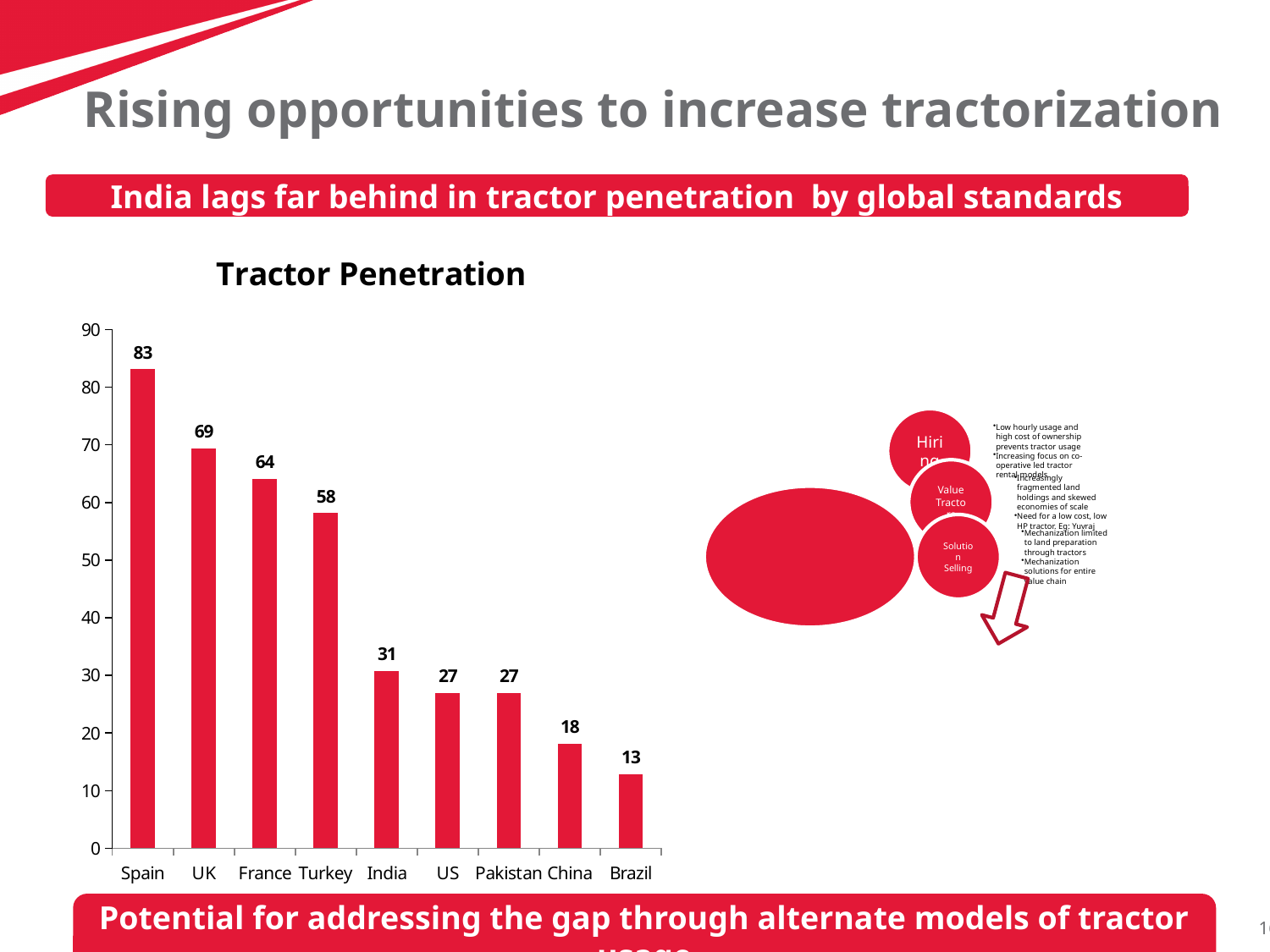
Which country has the highest tractor penetration in the chart? Spain What is the difference in tractor penetration between Spain and India? 52 Which country has the lowest tractor penetration in the chart? Brazil What is the difference in tractor penetration between UK and France? 5 What type of chart is used to show Tractor Penetration? Bar chart What is the tractor penetration value for Spain? 83 What is the tractor penetration value for India? 31 Do the tractor penetration values rise or fall from Spain to Brazil along the x axis? Fall Which has a higher tractor penetration, Turkey or China? Turkey Is the tractor penetration value for Turkey greater or less than 50? greater How many countries are shown in the Tractor Penetration chart? 9 What is the title of the chart on the slide? Tractor Penetration